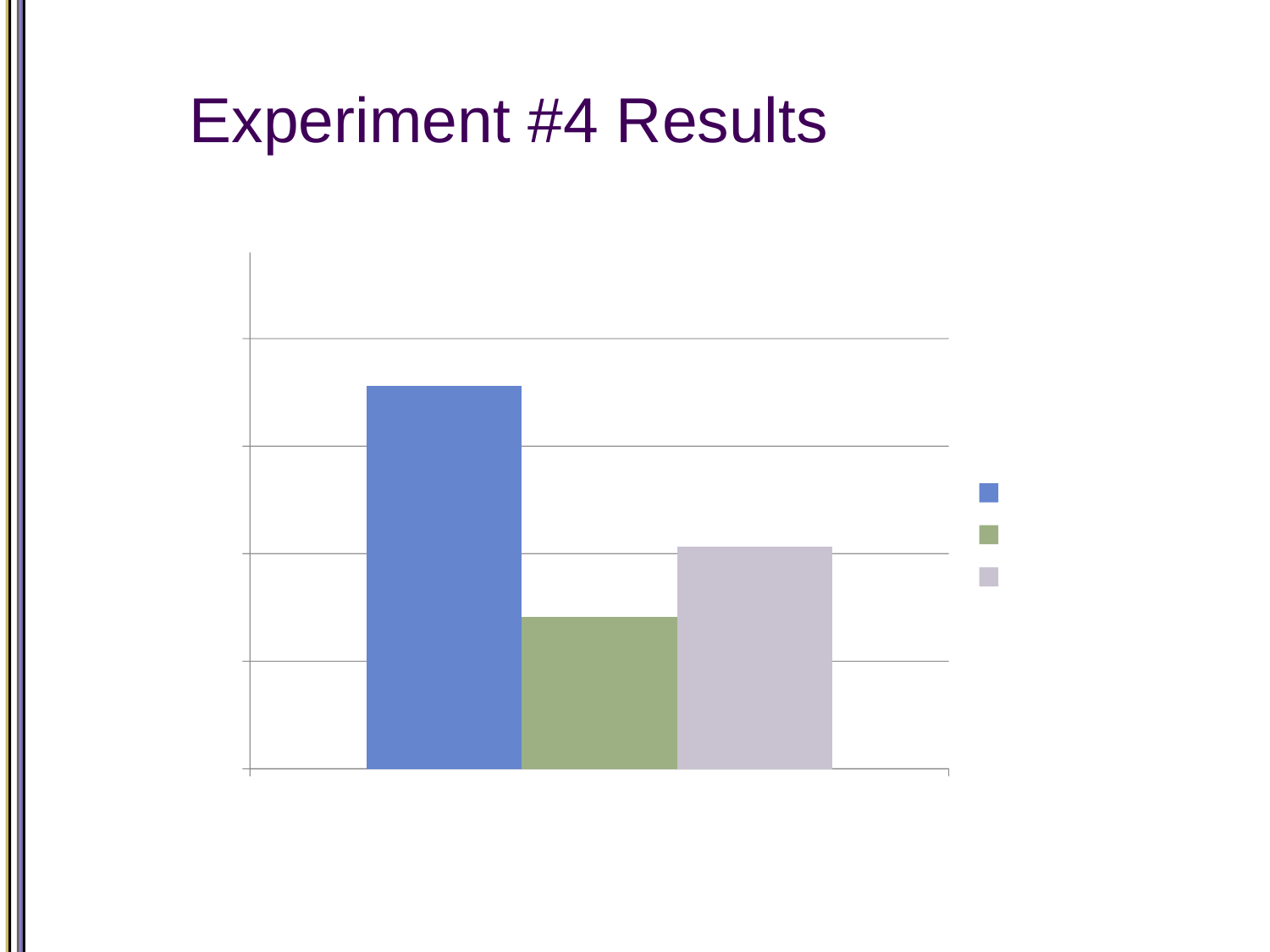
Which bar is the tallest in the chart? the blue bar Which bar is the shortest in the chart? the green bar What colour is the first (leftmost) bar in the chart? blue Which is taller, the green bar or the grey bar? the grey bar What is the title of the slide containing the chart? Experiment #4 Results How many bars are plotted in the chart? 3 Which is taller, the blue bar or the grey bar? the blue bar How many entries does the chart's legend list? 3 What kind of chart is shown on the slide? bar chart